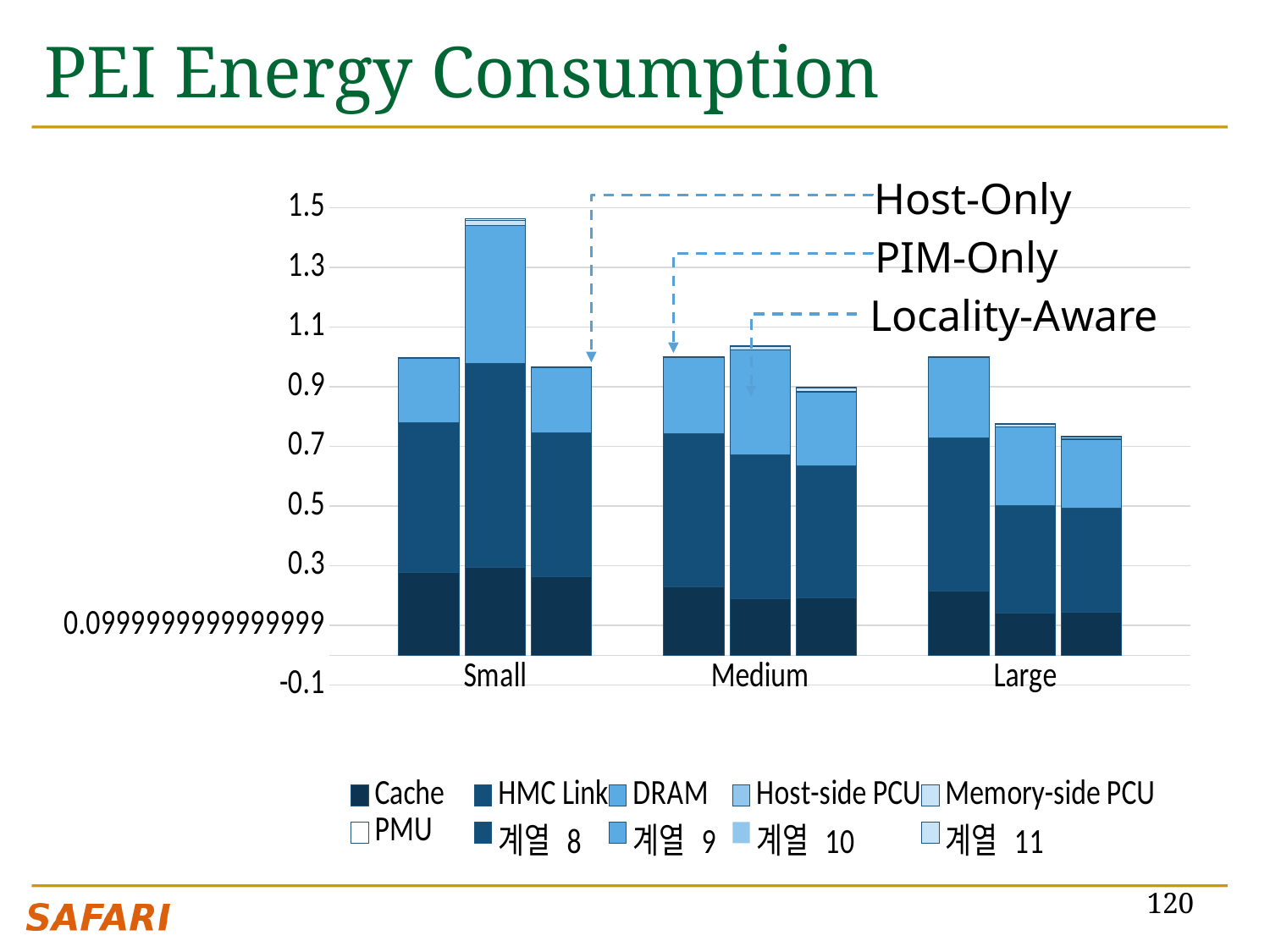
Is the PIM-Only bar for Small greater or less than 1.3? greater Which bar is the tallest in the chart? PIM-Only for Small How many series does the legend list? 10 What is the title of the chart? PEI Energy Consumption Is the PIM-Only bar for Large greater or less than 0.9? less Which is taller for Large, the Host-Only bar or the PIM-Only bar? Host-Only What kind of chart is shown on the slide? stacked bar chart How many categories are shown on the x axis? 3 What are the three bar configurations labelled by the dashed arrows? Host-Only, PIM-Only, Locality-Aware Is the Locality-Aware bar for Small greater or less than 1.1? less Do the PIM-Only bars rise or fall from Small to Large? fall Which is taller for Medium, the PIM-Only bar or the Locality-Aware bar? PIM-Only